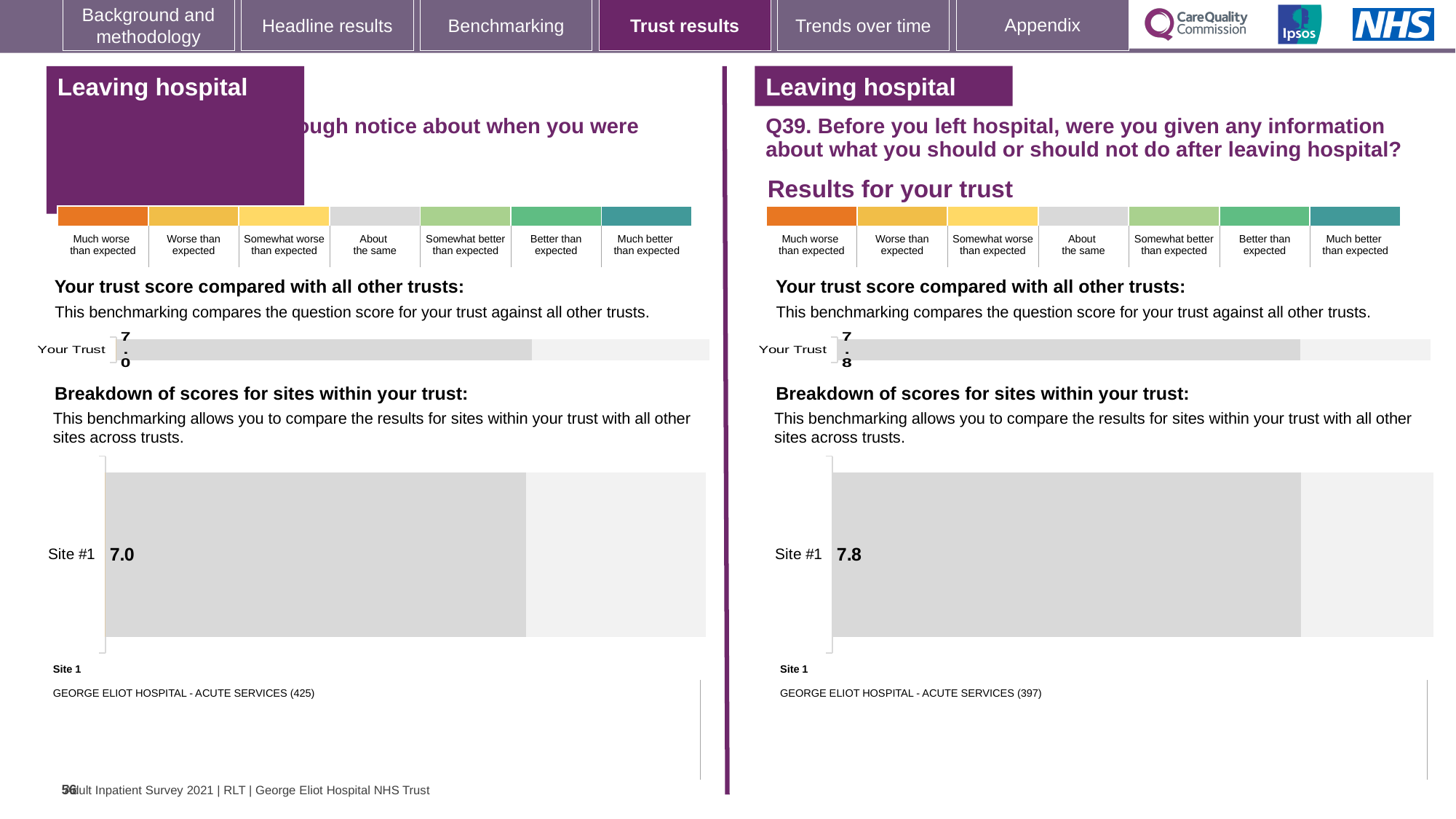
Which site is listed as Site 1 beneath the right-hand (Q39) breakdown chart? GEORGE ELIOT HOSPITAL - ACUTE SERVICES (397) What type of chart is used to show the Your Trust score on the left half of the slide? Bar chart How many sites are shown in the right-hand (Q39) 'Breakdown of scores for sites within your trust' chart? 1 What is the difference between the Site #1 score in the right-hand (Q39) chart and the Site #1 score in the left-hand chart? 0.8 On the left half of the slide, what is the score shown for Your Trust? 7.0 What type of chart is used to show the Site #1 score on the right half of the slide (Q39)? Bar chart On the right half of the slide (Q39), what is the score shown for Your Trust? 7.8 In the right-hand (Q39) 'Breakdown of scores for sites within your trust' chart, what is the score for Site #1? 7.8 How many sites are shown in the left-hand 'Breakdown of scores for sites within your trust' chart? 1 Which site is listed as Site 1 beneath the left-hand breakdown chart? GEORGE ELIOT HOSPITAL - ACUTE SERVICES (425) Which is larger: the Your Trust score on the left half of the slide or the Your Trust score on the right half (Q39)? Right half (Q39), 7.8 In the left-hand 'Breakdown of scores for sites within your trust' chart, what is the score for Site #1? 7.0